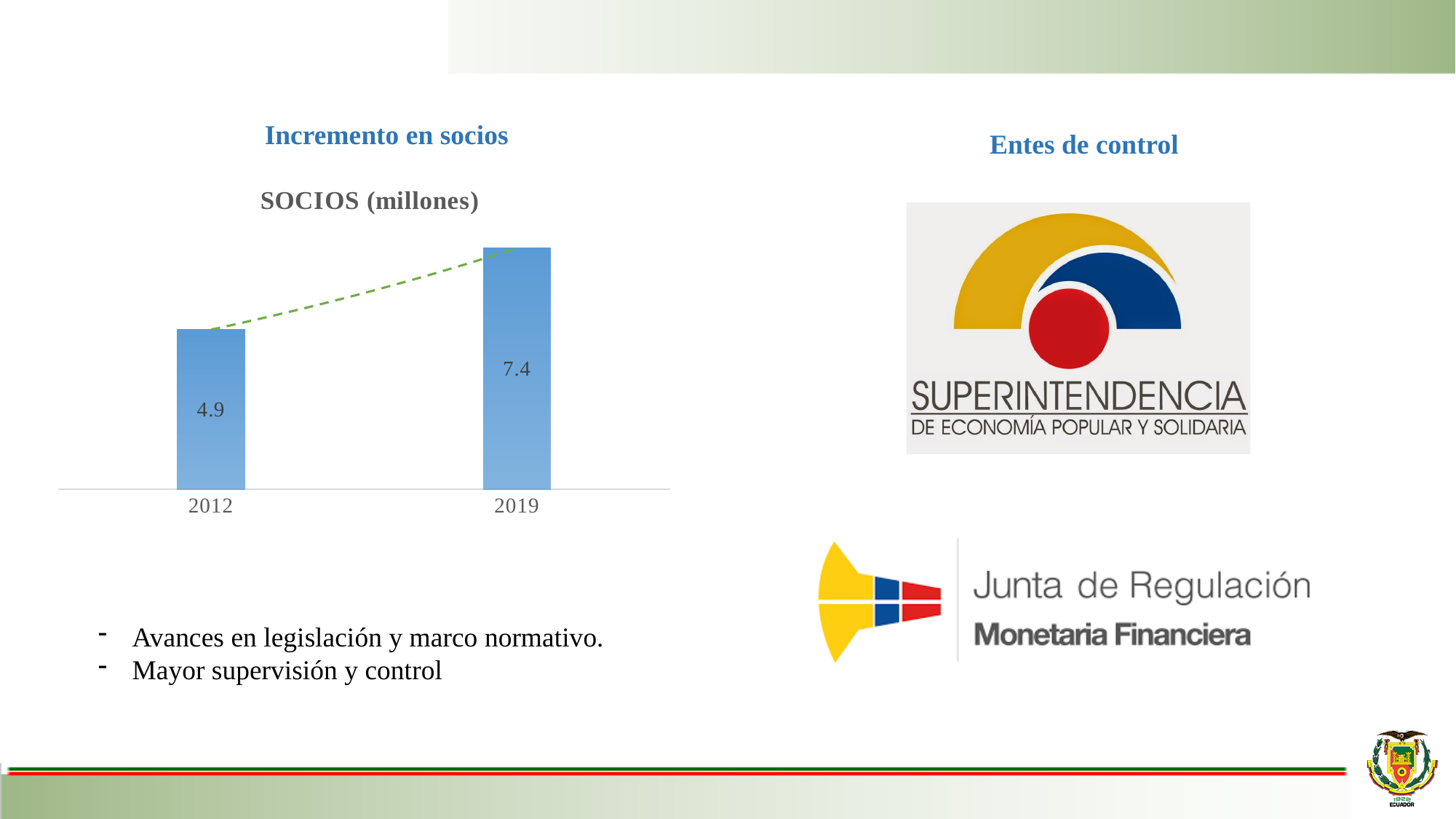
What is the difference between the 2019 and 2012 values in the SOCIOS (millones) chart? 2.5 What colour are the bars in the SOCIOS (millones) chart? Blue In the SOCIOS (millones) chart, which is larger, the value for 2012 or the value for 2019? 2019 How many bars are shown in the SOCIOS (millones) chart? 2 Which year has the highest value in the SOCIOS (millones) chart? 2019 What is the value for 2019 in the SOCIOS (millones) chart? 7.4 What kind of chart is the SOCIOS (millones) chart? Bar chart What is the value for 2012 in the SOCIOS (millones) chart? 4.9 Which year has the lowest value in the SOCIOS (millones) chart? 2012 Do the values in the SOCIOS (millones) chart rise or fall from 2012 to 2019? Rise What is the title of the chart on the slide? SOCIOS (millones)